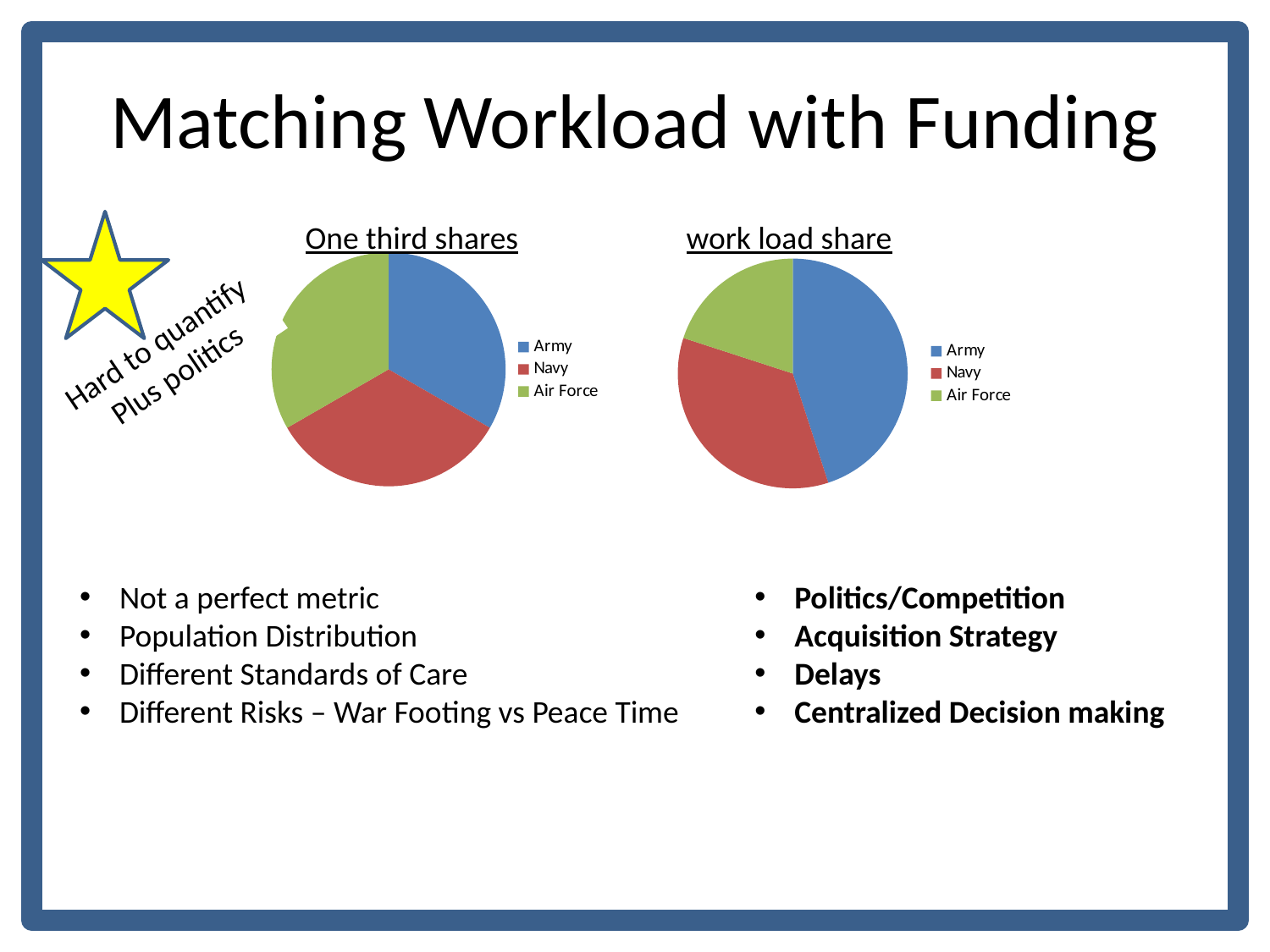
What kind of chart is the "work load share" chart? pie chart What are the three categories listed in the legend of the "One third shares" chart? Army, Navy, Air Force In the "work load share" chart, which category has the smallest slice? Air Force How many entries does the legend of the "work load share" chart list? 3 How many slices does the "work load share" pie chart have? 3 How many slices does the "One third shares" pie chart have? 3 In the "work load share" chart, which category has the largest slice? Army In the "work load share" chart, what colour is the Navy slice? red What kind of chart is the "One third shares" chart? pie chart In the "work load share" chart, which slice is larger, Army or Air Force? Army In the "work load share" chart, which slice is larger, Navy or Air Force? Navy